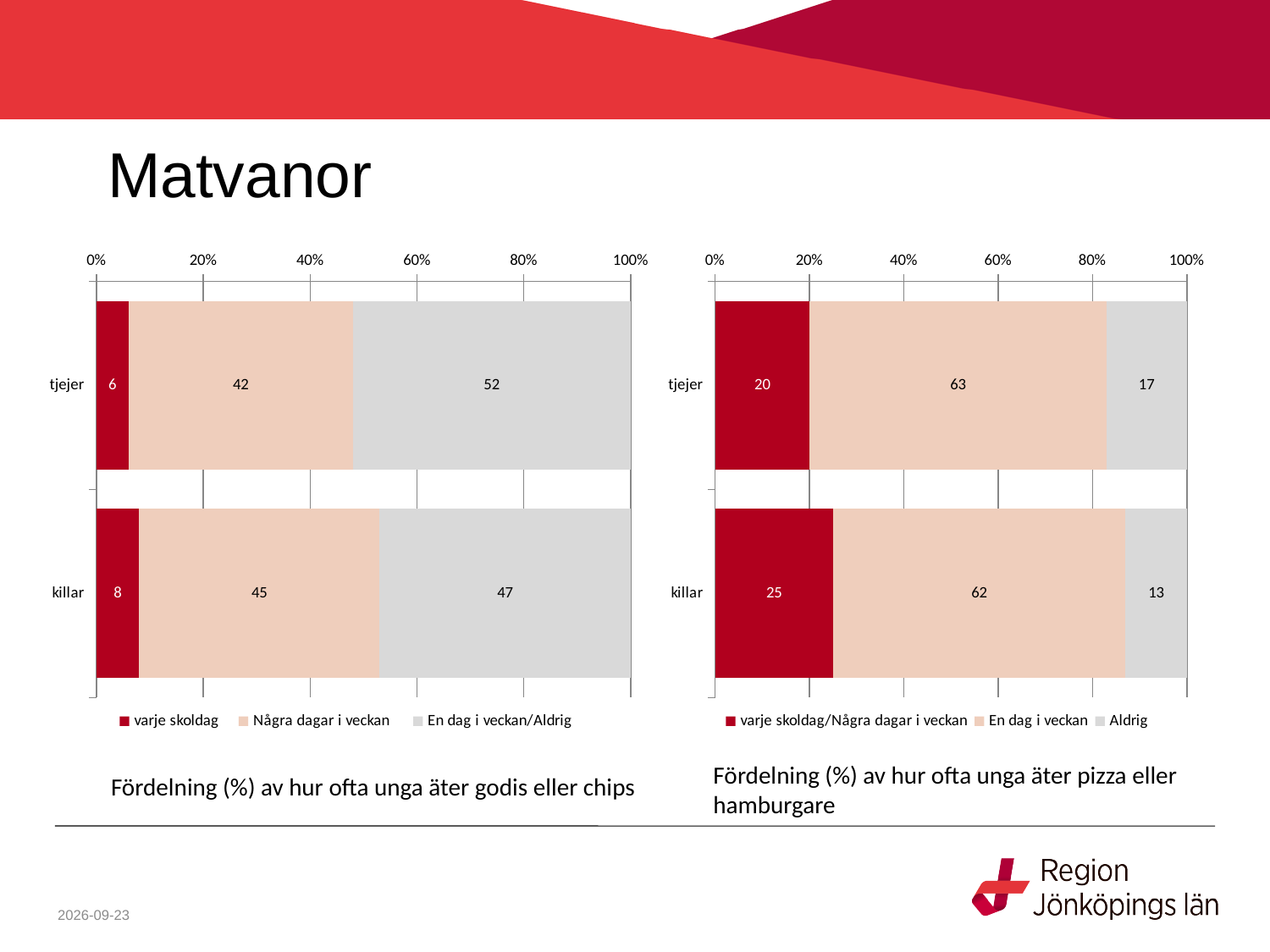
In the right chart (pizza eller hamburgare), what is the value for 'varje skoldag/Några dagar i veckan' for killar? 25 In the right chart (pizza eller hamburgare), which group has the larger 'varje skoldag/Några dagar i veckan' value, tjejer or killar? killar In the left chart (godis eller chips), what is the value for 'En dag i veckan/Aldrig' for killar? 47 In the left chart (godis eller chips), what is the difference between the 'varje skoldag' values for killar and tjejer? 2 In the right chart (pizza eller hamburgare), what is the value for 'Aldrig' for tjejer? 17 In the left chart (godis eller chips), what is the total of the stacked bar for tjejer? 100 What kind of chart is the right chart (pizza eller hamburgare)? Stacked bar chart How many categories are shown on the y axis of the left chart (godis eller chips)? 2 In the left chart (godis eller chips), which group has the larger 'En dag i veckan/Aldrig' value, tjejer or killar? tjejer In the right chart (pizza eller hamburgare), what is the difference between the 'Aldrig' values for tjejer and killar? 4 In the left chart (godis eller chips), what is the value for 'Några dagar i veckan' for tjejer? 42 How many series does the legend of the right chart (pizza eller hamburgare) list? 3